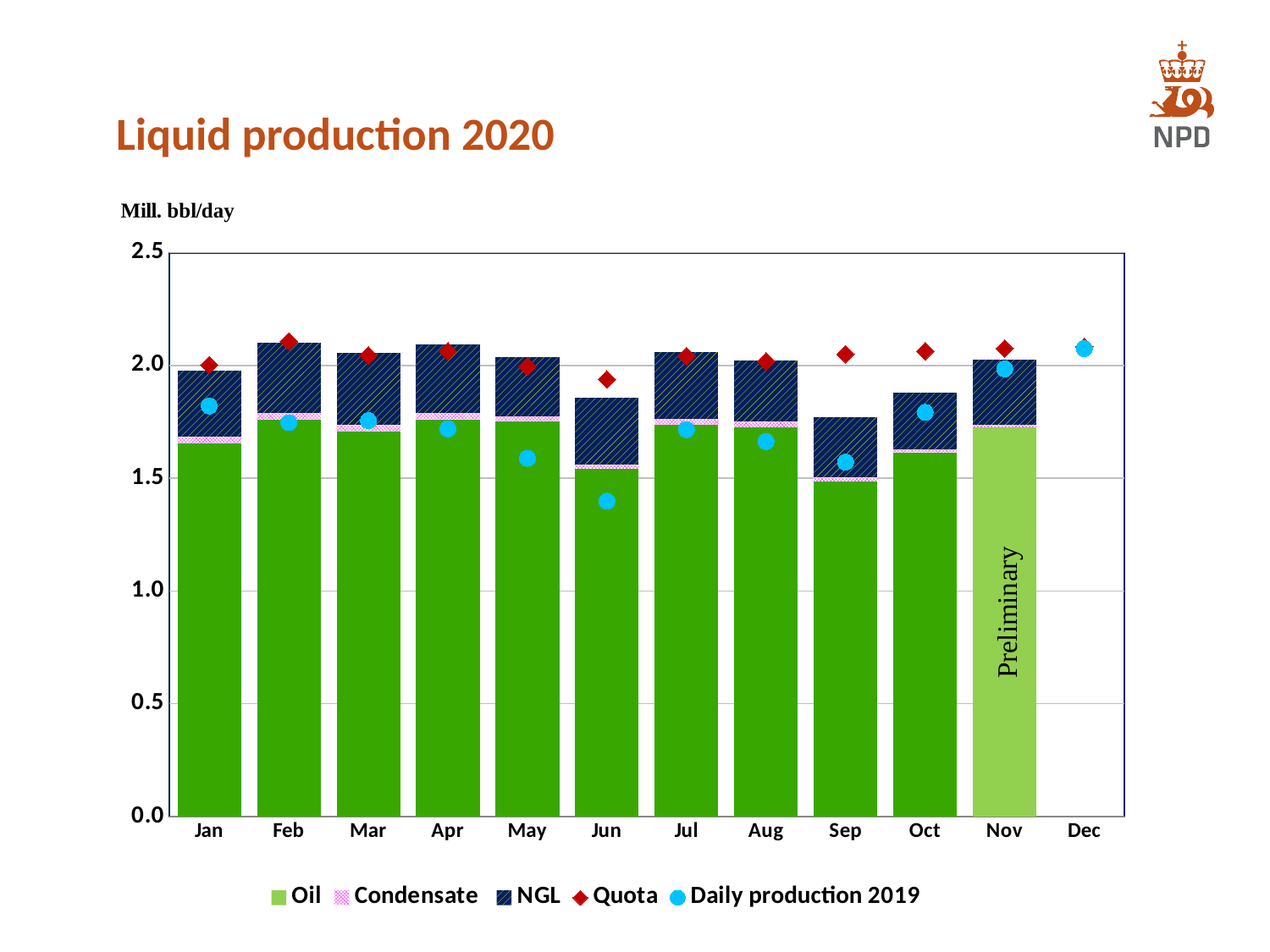
How many months have a stacked bar plotted? 11 Is the Oil value for Jan greater or less than 1.5? greater Which month has the lowest total stacked bar? Sep Which is larger, the total stacked bar for Sep or for Oct? Oct Is the Daily production 2019 value for Jun greater or less than 1.5? less What kind of chart is shown on the slide? bar chart Is the total stacked bar for Feb greater or less than 2.0? greater How many series does the legend list? 5 How many months are labelled on the x axis? 12 Do the total stacked bars rise or fall from Jul to Sep? fall What unit is given for the y axis? Mill. bbl/day